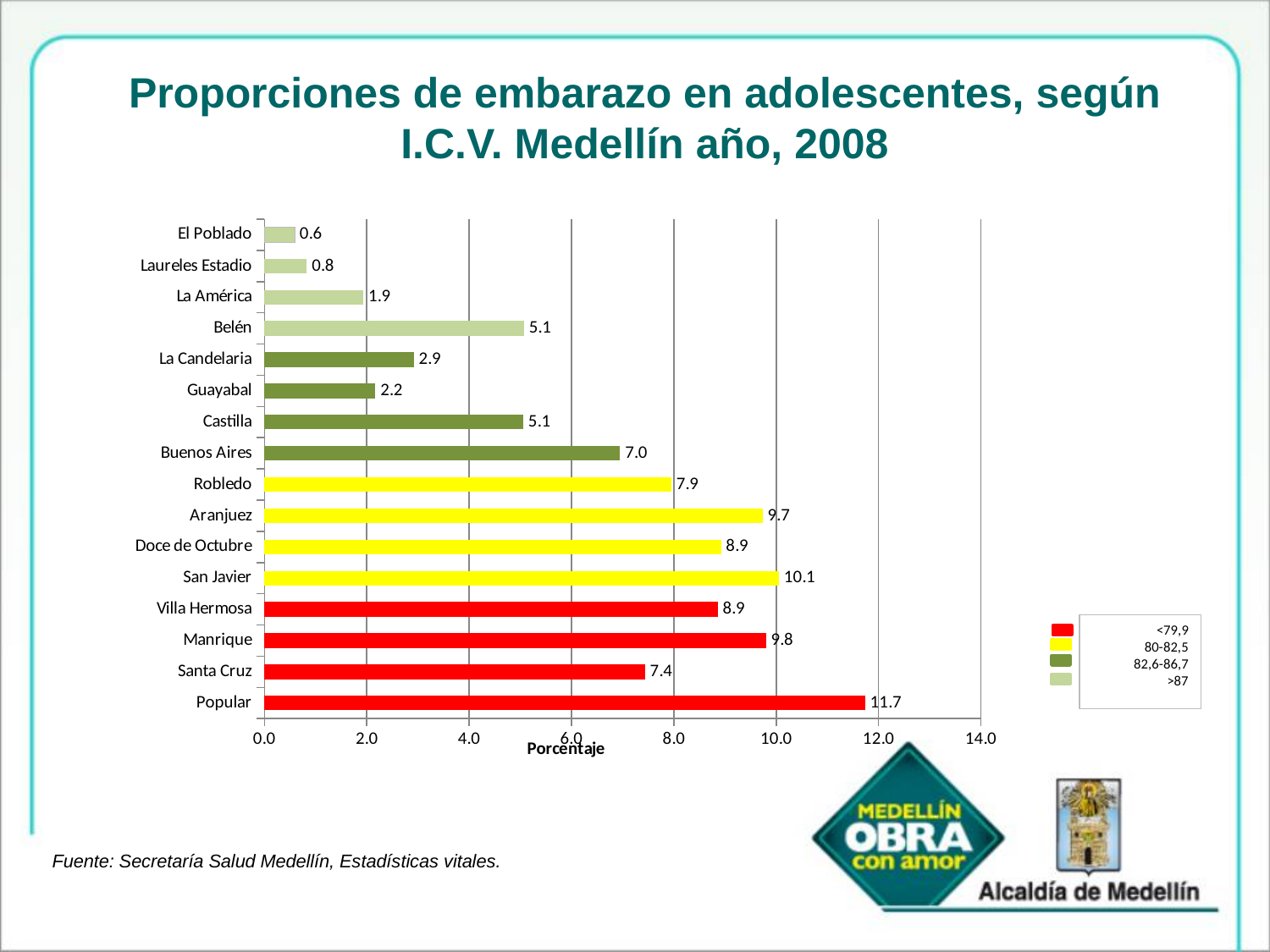
What kind of chart is shown on the slide? Bar chart What is the value for San Javier? 10.1 Which category has the lowest value? El Poblado What is the value for Popular? 11.7 How many entries does the legend list? 4 How many categories are shown on the chart? 16 What is the difference between the values for Popular and Santa Cruz? 4.3 Is the value for Buenos Aires greater or less than 6.0? greater What is the value for El Poblado? 0.6 What is the label of the horizontal axis? Porcentaje Which is larger, the value for Aranjuez or the value for Robledo? Aranjuez Which category has the highest value? Popular